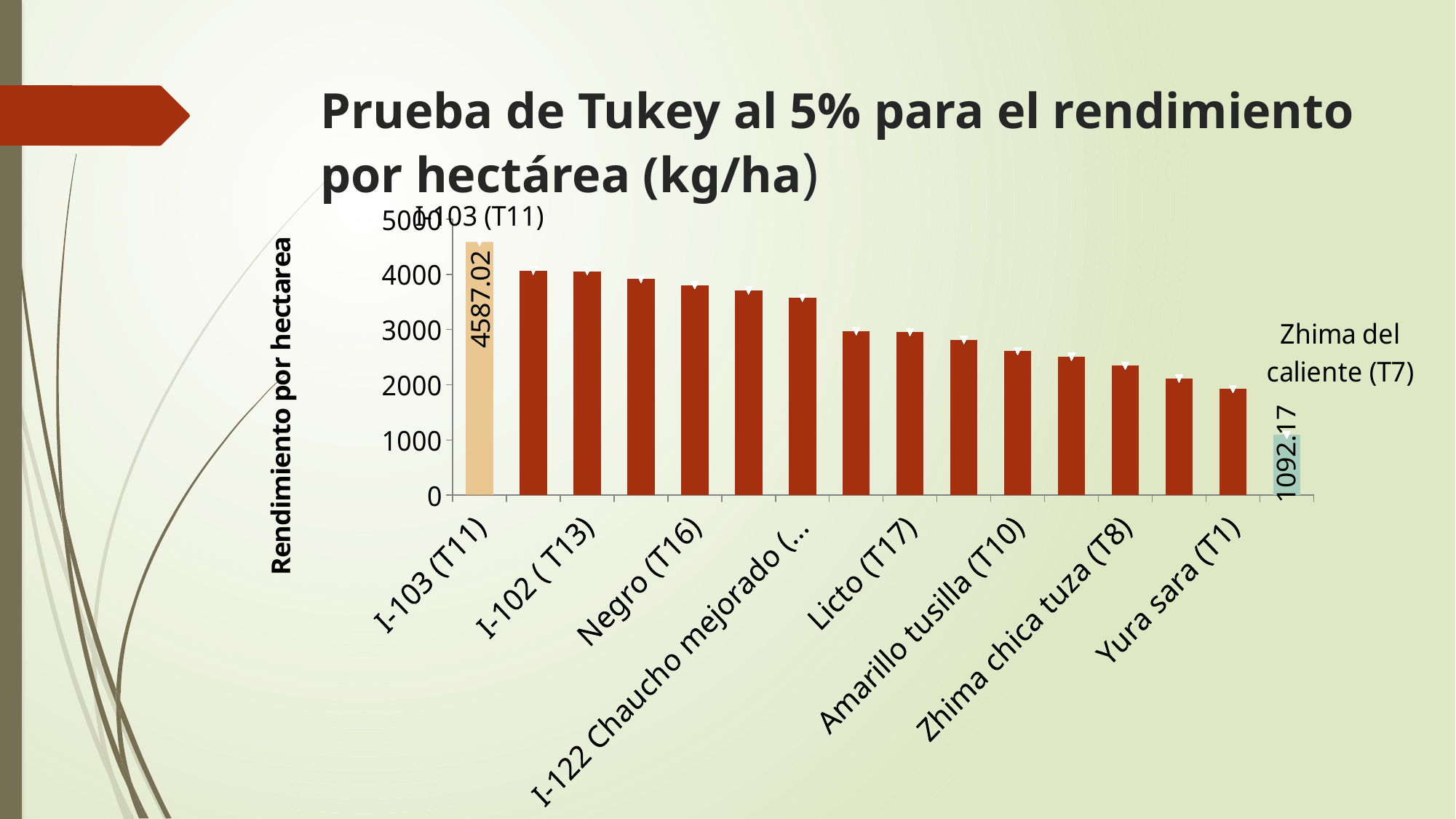
What is the value for Zhima del caliente (T7)? 1092.17 What is the label of the vertical axis? Rendimiento por hectarea Is the value for Zhima chica tuza (T8) greater or less than 2000? greater Is the value for Amarillo tusilla (T10) greater or less than 3000? less How many bars are plotted in the chart? 16 What is the value for I-103 (T11)? 4587.02 What type of chart is shown on the slide? bar chart What is the difference between the values for I-103 (T11) and Zhima del caliente (T7)? 3494.85 Which is larger, the value for I-103 (T11) or the value for Zhima del caliente (T7)? I-103 (T11) Do the values rise or fall from left to right along the x axis? fall Which category has the highest yield per hectare? I-103 (T11) Which category has the lowest yield per hectare? Zhima del caliente (T7)